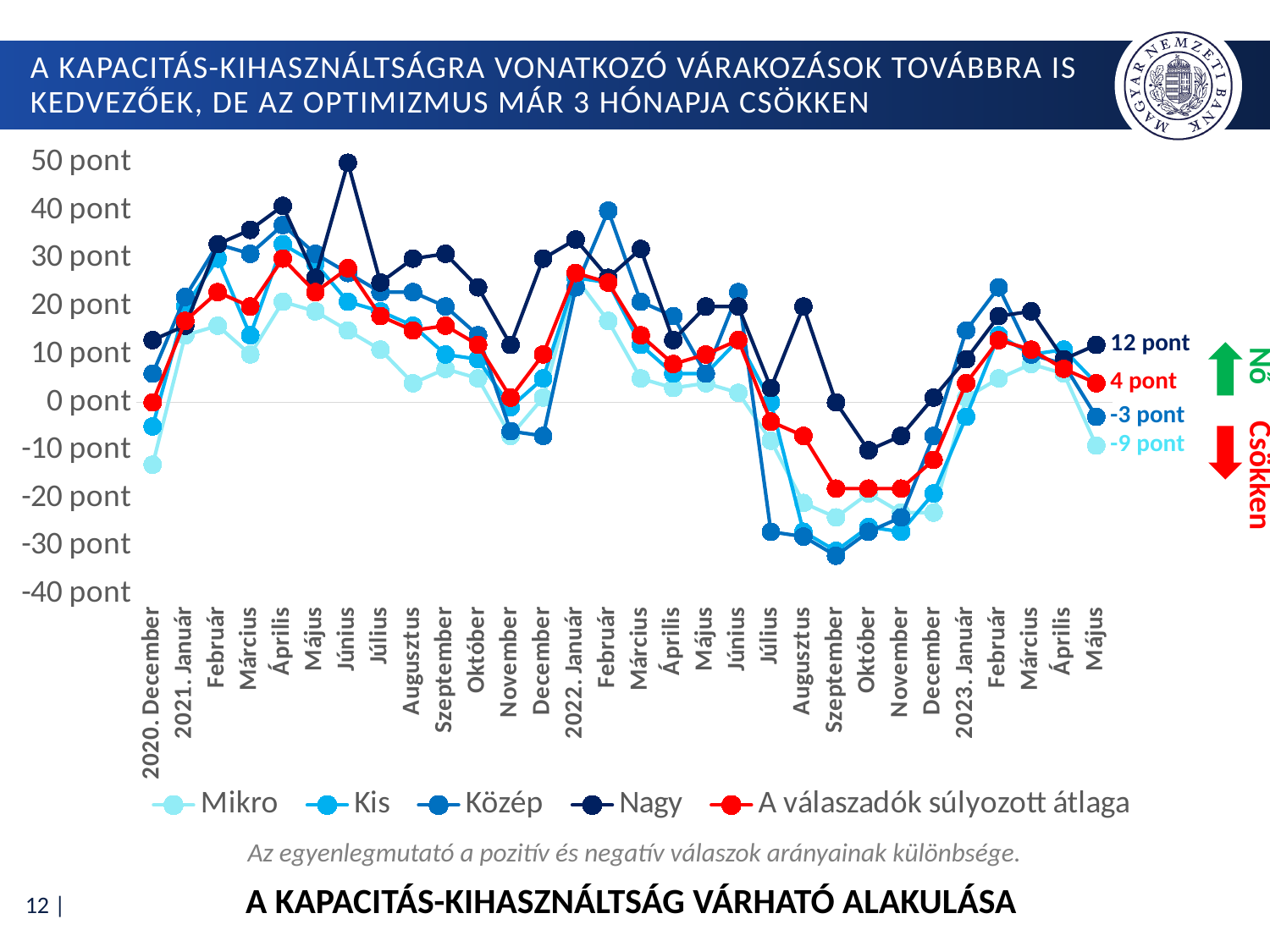
How many months (points) are shown along the x axis? 30 At 2023 Május, which is larger: the Nagy value or the weighted average ('A válaszadók súlyozott átlaga')? Nagy What is the value of 'A válaszadók súlyozott átlaga' at the last point (2023 Május)? 4 pont What kind of chart is shown on the slide? line chart What is the value of the Mikro series at the last point (2023 Május)? -9 pont Is the value for Közép in 2022 Szeptember greater or less than -20 pont? less What is the value of the Közép series at the last point (2023 Május)? -3 pont What is the value of the Nagy series at the last point (2023 Május)? 12 pont Is the value for Nagy in 2021 Június greater or less than 40 pont? greater How many series does the legend list? 5 Which series has the highest value at 2023 Május? Nagy What is the difference between the Nagy value and the Mikro value at 2023 Május? 21 pont